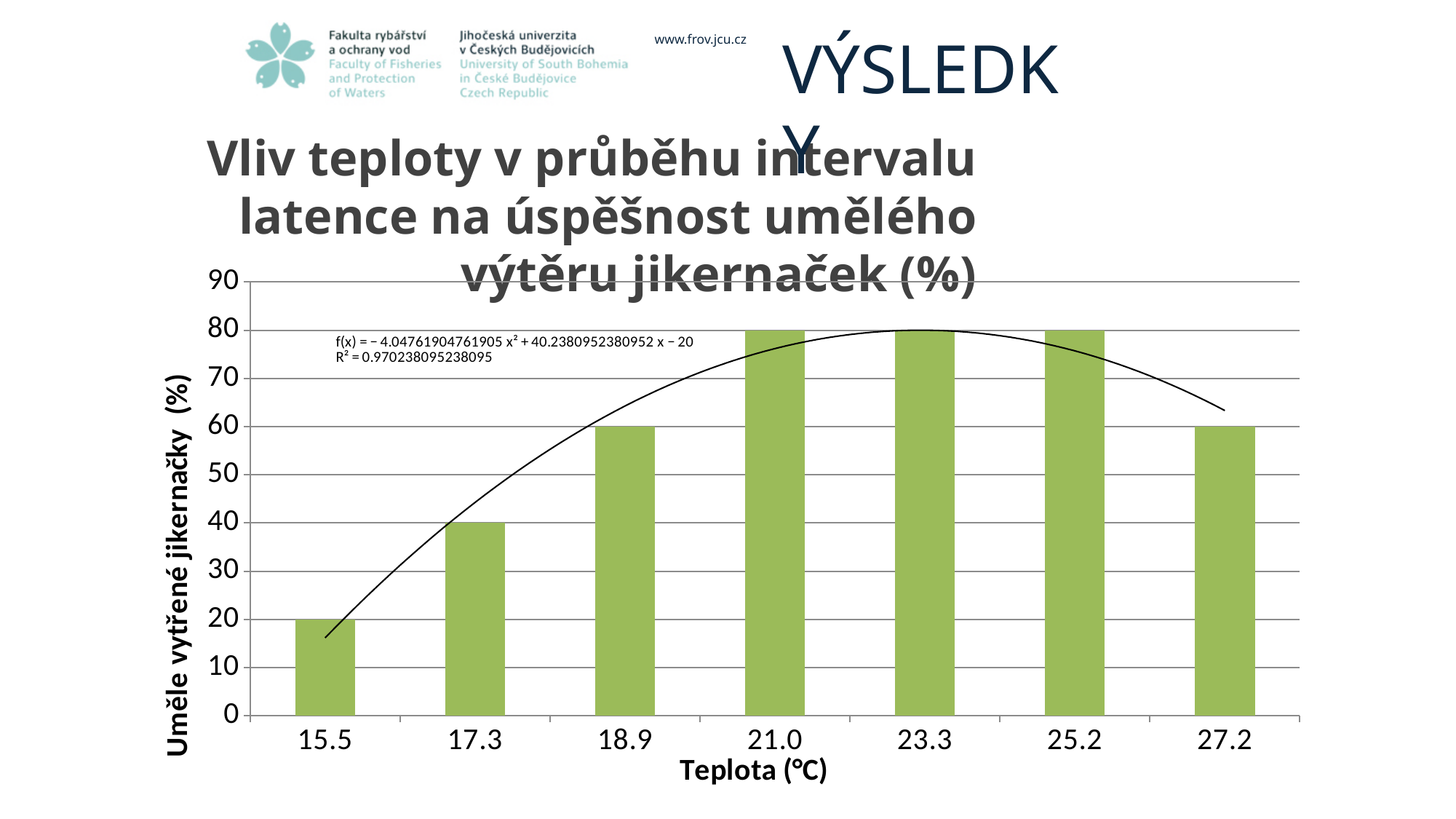
Do the values rise or fall from 15.5 °C to 21.0 °C along the x axis? rise What is the label of the x axis? Teplota (°C) What is the value for the temperature 15.5 °C? 20 What type of chart is shown on the slide? bar chart What is the difference between the values for 23.3 °C and 18.9 °C? 20 How many temperature categories are plotted on the x axis? 7 Which has the larger value, 17.3 °C or 25.2 °C? 25.2 Is the value for 18.9 °C greater or less than 50? greater Which temperature has the lowest value? 15.5 What is the value for the temperature 21.0 °C? 80 What is the value for the temperature 27.2 °C? 60 What is the value for the temperature 17.3 °C? 40